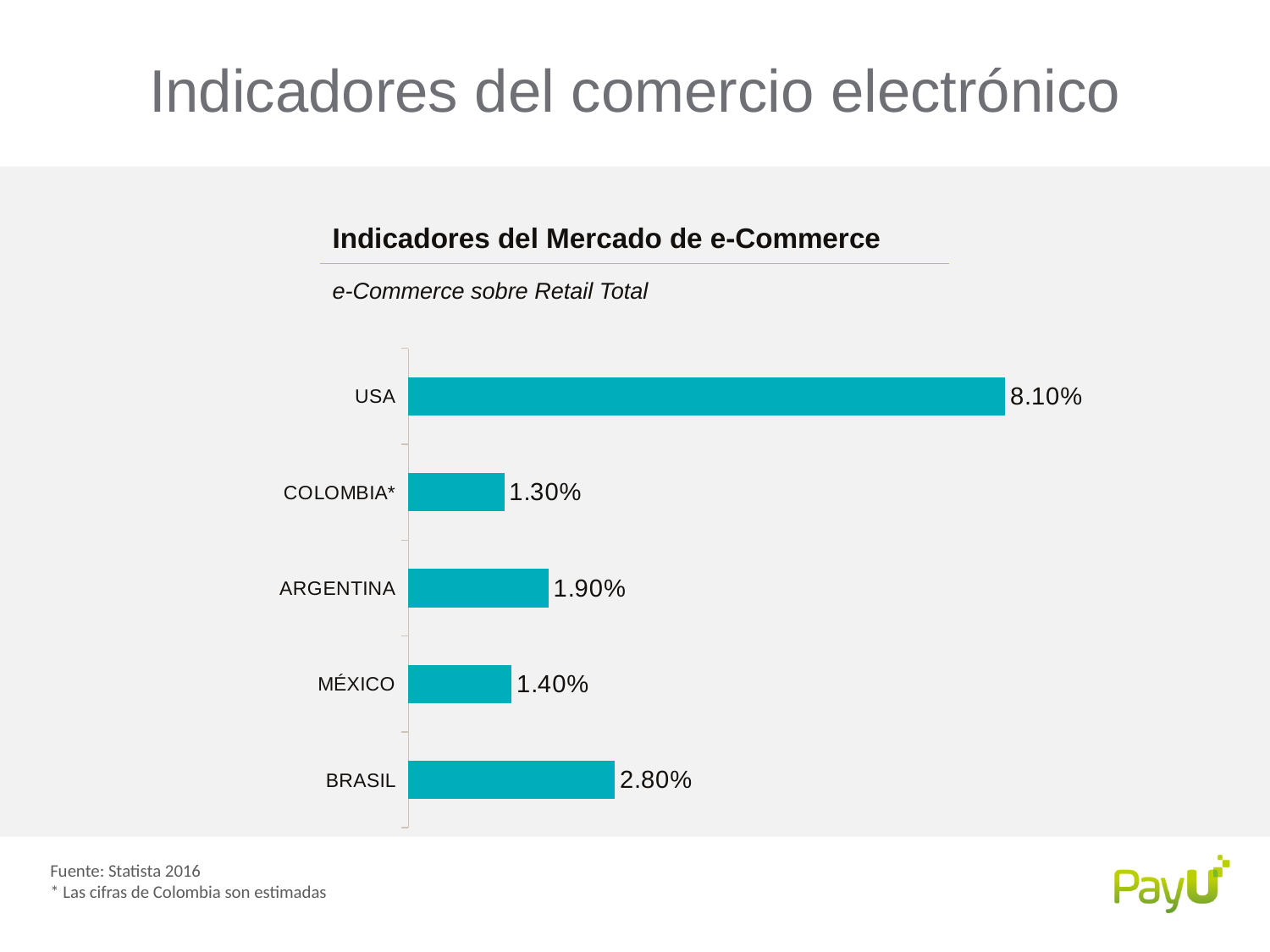
What is the value for BRASIL? 2.80% What is the difference between the values for ARGENTINA and COLOMBIA*? 0.60% How many countries are shown in the chart? 5 Which country has the highest value? USA What is the value for ARGENTINA? 1.90% Which country has the lowest value? COLOMBIA* What is the value for USA? 8.10% What is the title of the chart? Indicadores del Mercado de e-Commerce Which is larger, the value for BRASIL or the value for ARGENTINA? BRASIL What is the value for MÉXICO? 1.40% What is the difference between the values for USA and BRASIL? 5.30% What kind of chart is this? Bar chart